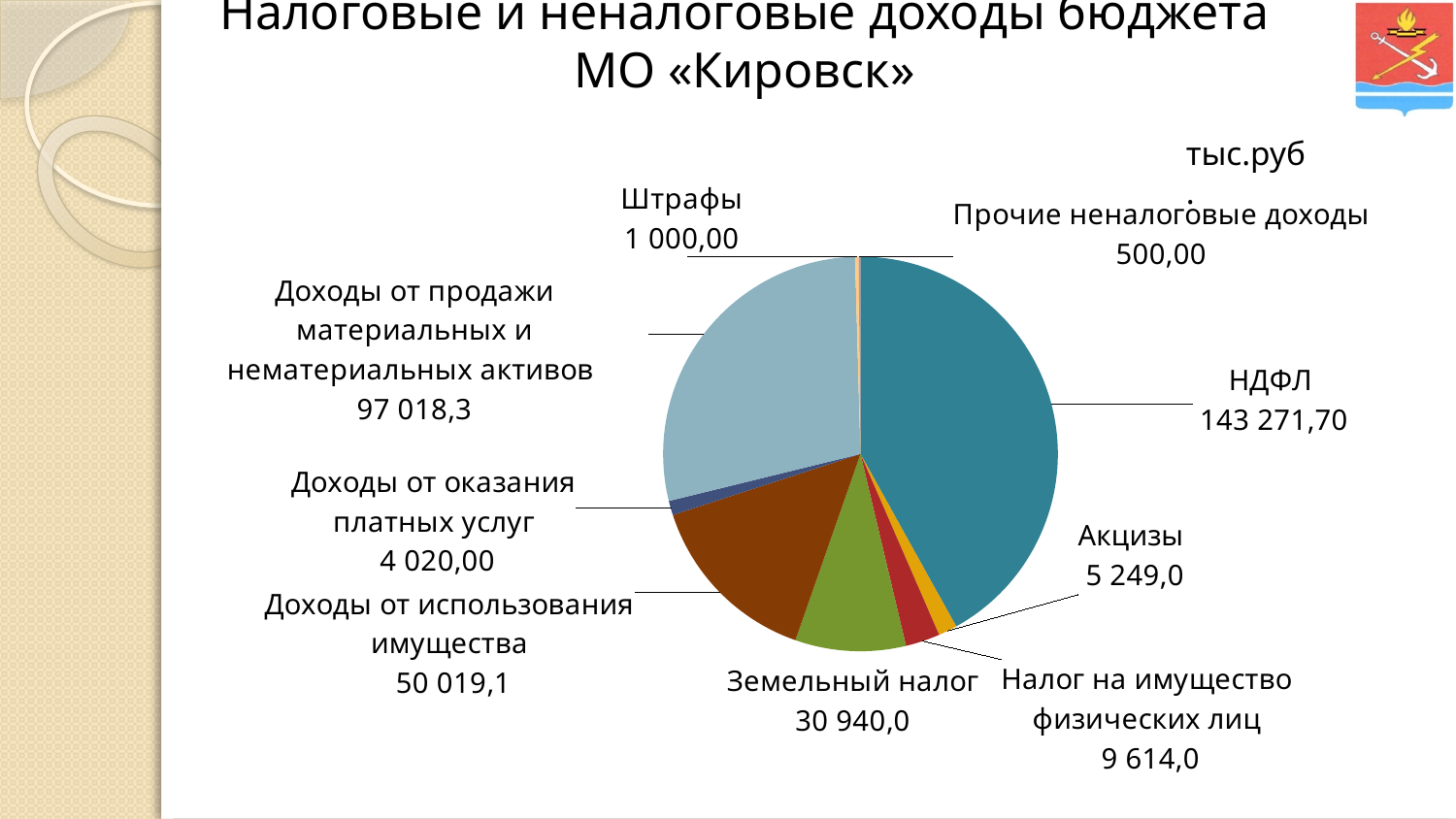
In what units are the values on the chart given? тыс.руб What type of chart is shown on the slide? pie chart What is the value for Акцизы? 5 249,0 What is the value for Доходы от продажи материальных и нематериальных активов? 97 018,3 How many categories are shown in the pie chart? 9 What is the value for НДФЛ? 143 271,70 What is the value for Земельный налог? 30 940,0 Which category has the largest slice of the pie? НДФЛ Which is larger: Доходы от использования имущества or Земельный налог? Доходы от использования имущества Which category has the smallest slice of the pie? Прочие неналоговые доходы What is the difference between Штрафы and Прочие неналоговые доходы? 500,00 What is the difference between Земельный налог and Налог на имущество физических лиц? 21 326,0